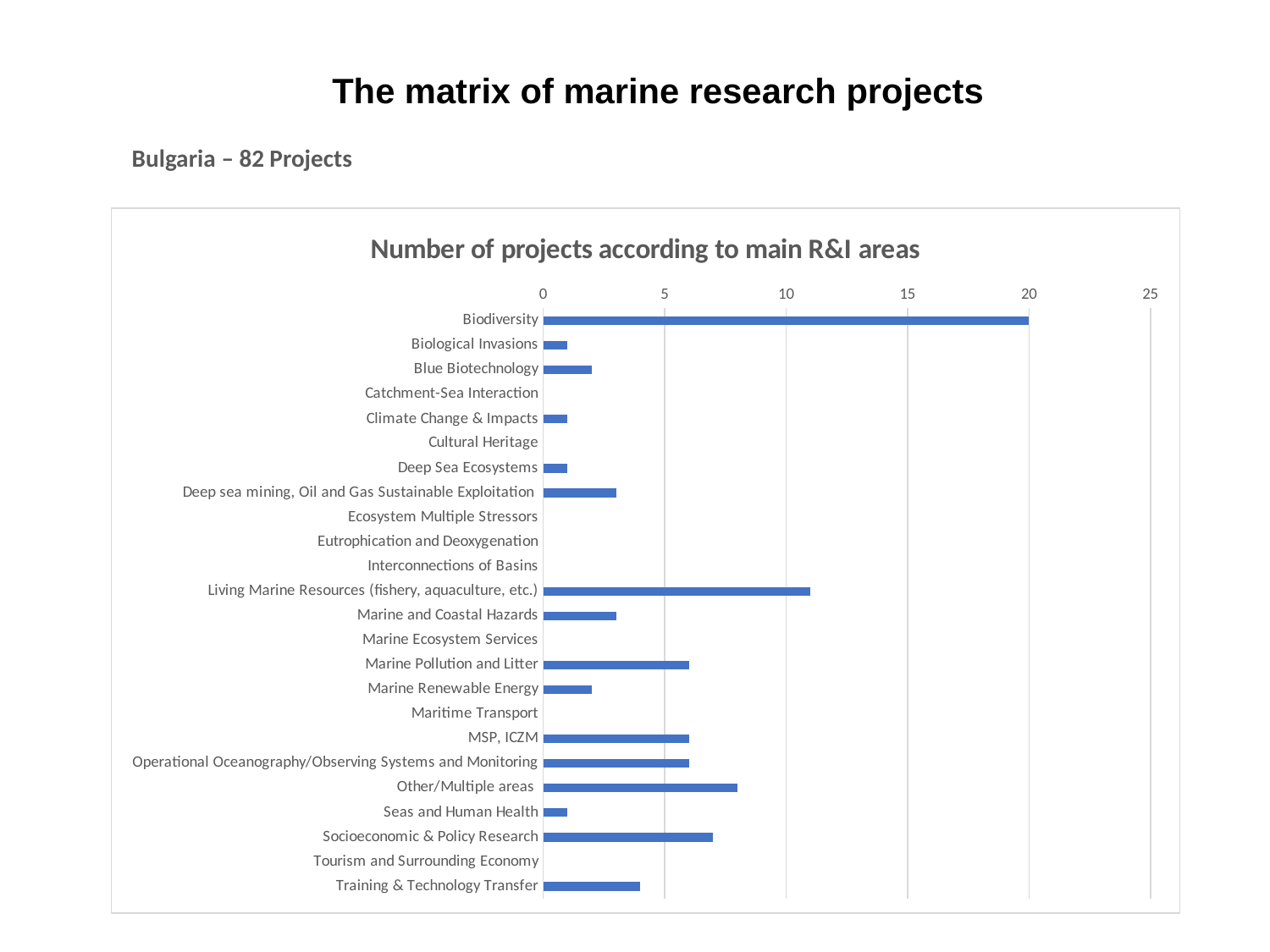
Which has more projects, Socioeconomic & Policy Research or Training & Technology Transfer? Socioeconomic & Policy Research What is the title of the chart? Number of projects according to main R&I areas Which has more projects, Deep sea mining, Oil and Gas Sustainable Exploitation or Biological Invasions? Deep sea mining, Oil and Gas Sustainable Exploitation Is the value for Other/Multiple areas greater or less than 10? less Which R&I area has the highest number of projects? Biodiversity Is the value for Training & Technology Transfer greater or less than 5? less How many projects are in the Biodiversity area? 20 Which has more projects, Biodiversity or Living Marine Resources (fishery, aquaculture, etc.)? Biodiversity Is the value for Marine Pollution and Litter greater or less than 5? greater What kind of chart is shown on the slide? bar chart How many R&I area categories are listed on the chart? 24